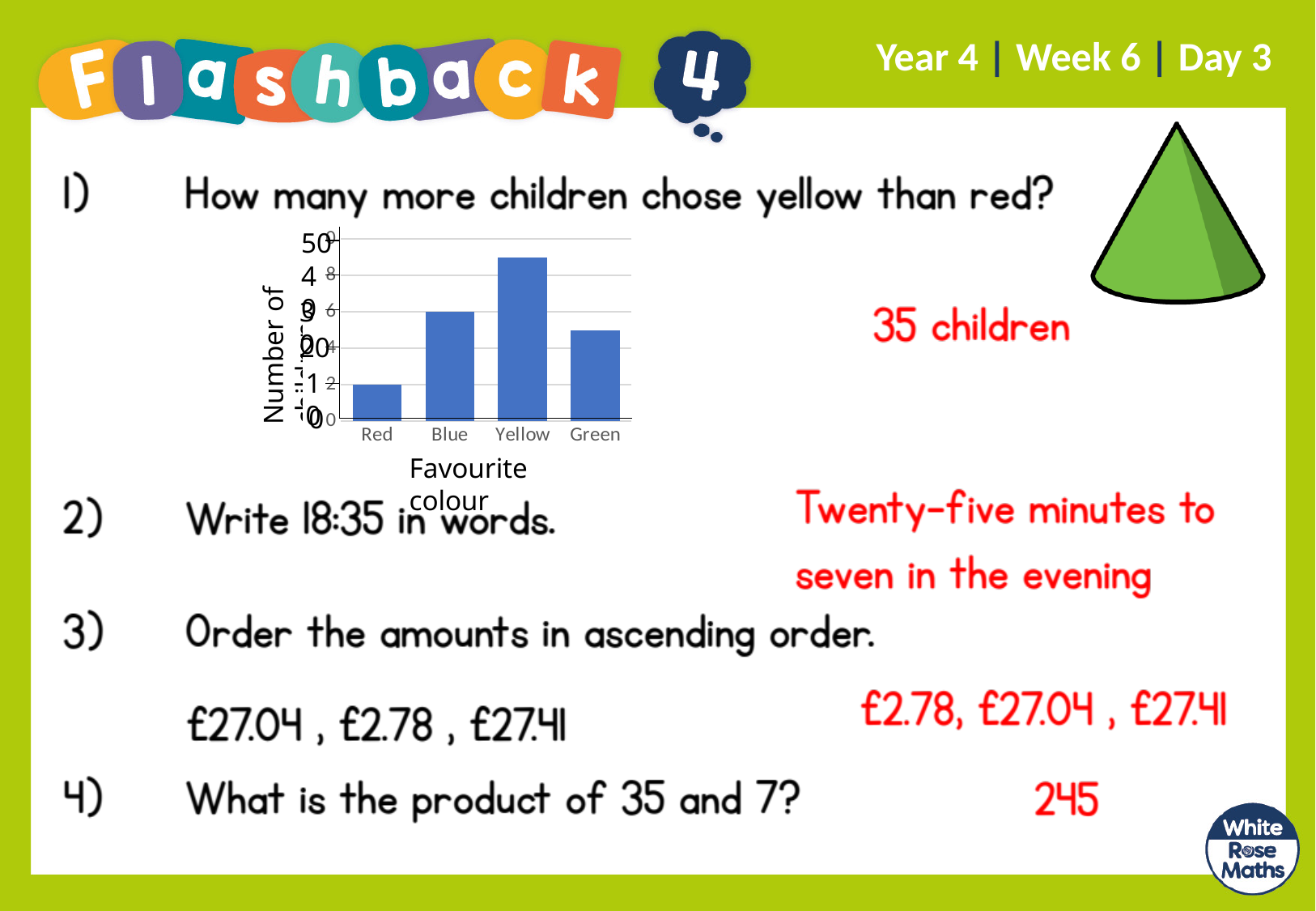
What is the title of the x axis of the chart? Favourite colour What kind of chart is shown on the slide? bar chart Which bar is taller in the chart, Yellow or Blue? Yellow How many categories are shown on the x axis of the chart? 4 Which bar is taller in the chart, Green or Red? Green What are the category labels along the x axis of the chart, from left to right? Red, Blue, Yellow, Green Which colour has the second-highest bar in the chart? Blue Which colour has the highest bar in the chart? Yellow Which bar is taller in the chart, Blue or Green? Blue Which colour has the lowest bar in the chart? Red